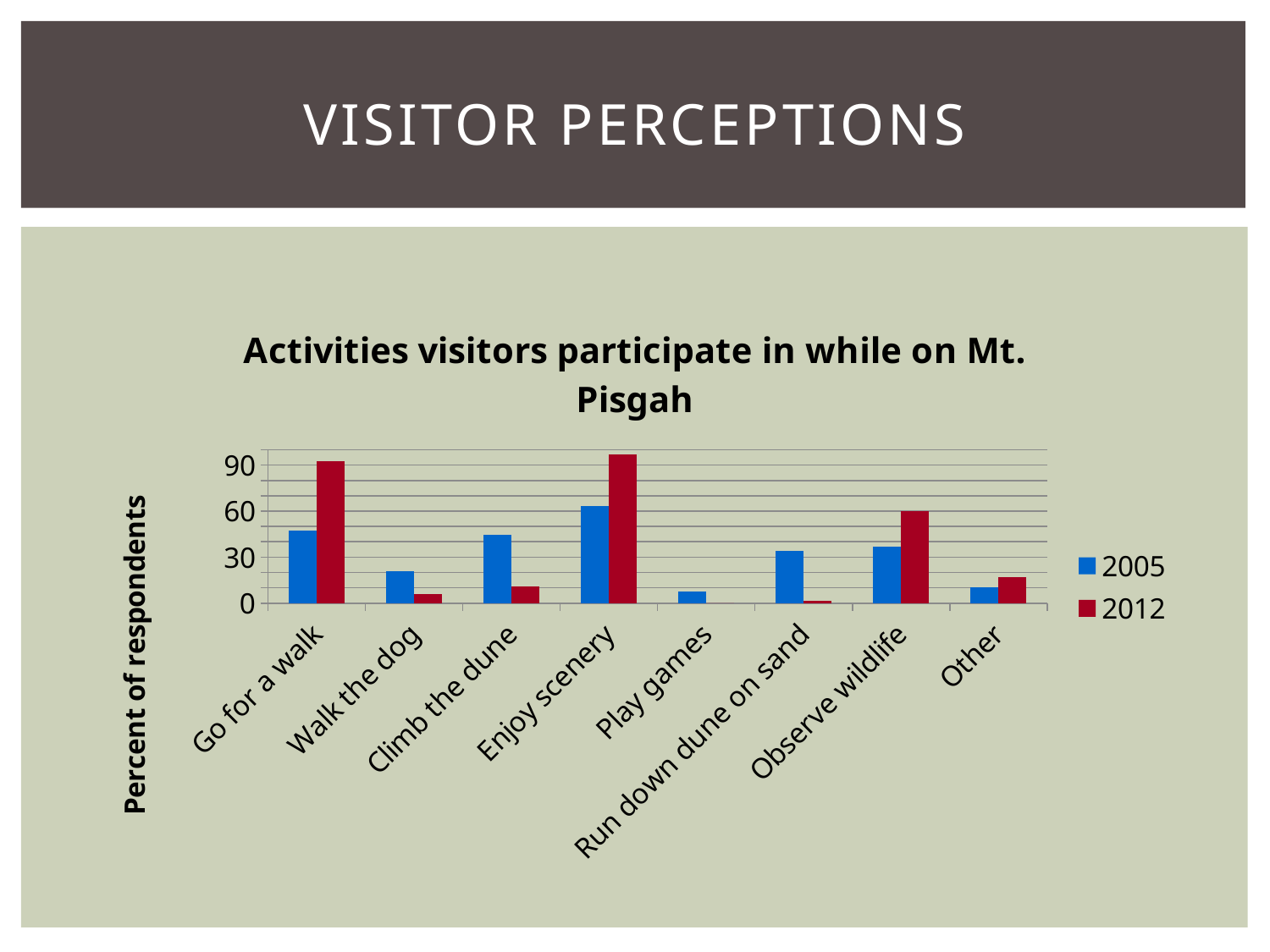
Is the 2005 value for Enjoy scenery greater or less than 30? greater For Go for a walk, which year has the larger value, 2005 or 2012? 2012 What is the title of the chart? Activities visitors participate in while on Mt. Pisgah Is the 2005 value for Walk the dog greater or less than 30? less For Climb the dune, which year has the larger value, 2005 or 2012? 2005 Which activity has the highest value for 2005? Enjoy scenery How many activity categories are shown on the x axis? 8 What kind of chart is shown on the slide? bar chart Is the 2012 value for Climb the dune greater or less than 30? less How many series does the legend list? 2 What is the label on the vertical axis? Percent of respondents